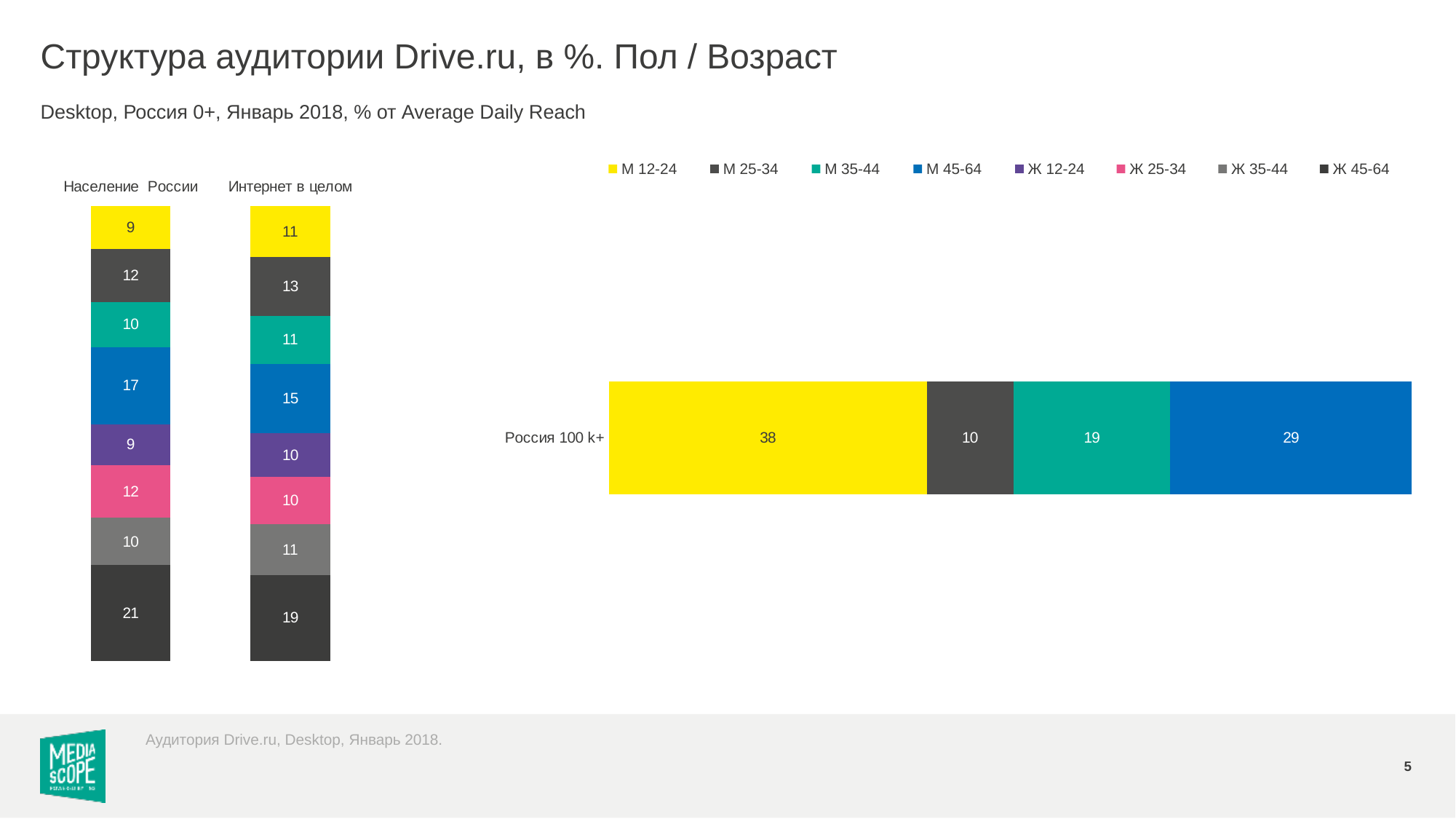
In the right chart, what is the value of the M 45-64 segment for Россия 100 k+? 29 In the left chart, which is larger: the M 25-34 value for Население России or for Интернет в целом? Интернет в целом What is the total of the Россия 100 k+ bar in the right chart? 96 In the right chart, what is the value of the M 12-24 segment for Россия 100 k+? 38 How many series does the legend list? 8 In the left chart, what is the value of the Ж 45-64 segment for Интернет в целом? 19 In the left chart, which segment is the largest in the Население России bar? Ж 45-64 In the right chart, what is the difference between the M 12-24 and M 45-64 segments for Россия 100 k+? 9 What kind of chart is the right chart? Stacked bar chart In the right chart, which segment is the smallest in the Россия 100 k+ bar? M 25-34 In the left chart, what is the value of the M 45-64 segment for Население России? 17 In the left chart, what is the difference between the M 45-64 values for Население России and Интернет в целом? 2